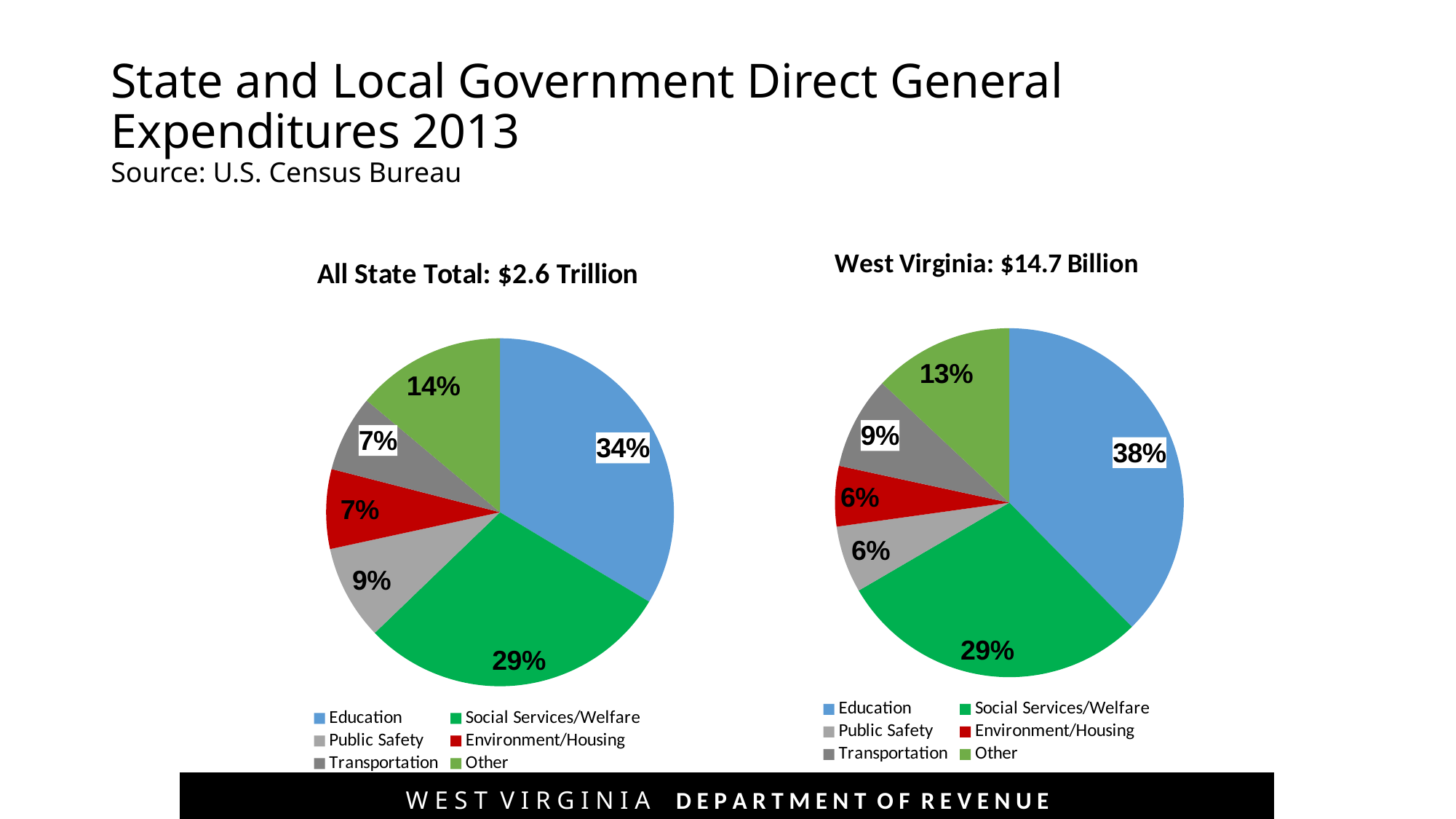
In the 'All State Total: $2.6 Trillion' pie chart, what share does Other have? 14% In the 'West Virginia: $14.7 Billion' pie chart, what share does Education have? 38% In the 'West Virginia: $14.7 Billion' pie chart, what share does Transportation have? 9% What type of chart is the 'All State Total: $2.6 Trillion' chart? Pie chart How many slices does the 'West Virginia: $14.7 Billion' pie chart have? 6 In the 'West Virginia: $14.7 Billion' pie chart, which category has the largest slice? Education In the 'West Virginia: $14.7 Billion' pie chart, what is the difference between the Education share and the Other share? 25% In the 'All State Total: $2.6 Trillion' pie chart, which category has the largest slice? Education In the 'All State Total: $2.6 Trillion' pie chart, what share does Education have? 34% In the 'All State Total: $2.6 Trillion' pie chart, what colour is the Environment/Housing slice? Red In the 'All State Total: $2.6 Trillion' pie chart, what is the difference between the Education share and the Social Services/Welfare share? 5% Which is larger: the Education share in the 'All State Total' pie chart or the Education share in the 'West Virginia' pie chart? West Virginia